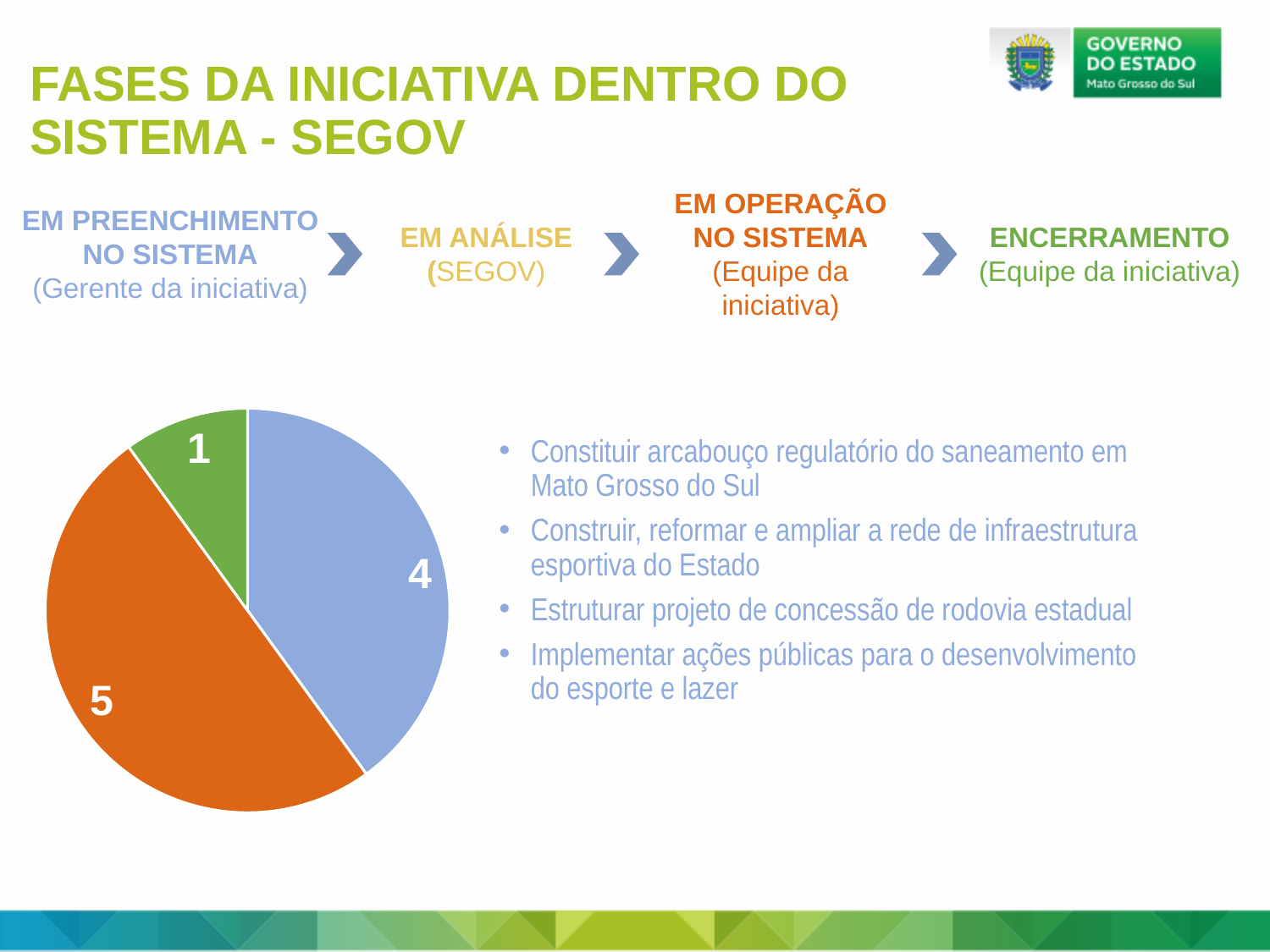
What is the total of all the slice values in the pie chart? 10 How many slices does the pie chart have? 3 Which slice of the pie chart has the largest value? the orange slice (5) What kind of chart is shown on the slide? pie chart What share of the pie chart does the orange slice represent? 50% Which is larger in the pie chart, the blue slice or the green slice? the blue slice What is the difference between the orange slice and the blue slice in the pie chart? 1 Which slice of the pie chart has the smallest value? the green slice (1) What value is shown on the orange slice of the pie chart? 5 What value is shown on the green slice of the pie chart? 1 What value is shown on the blue slice of the pie chart? 4 What is the difference between the blue slice and the green slice in the pie chart? 3